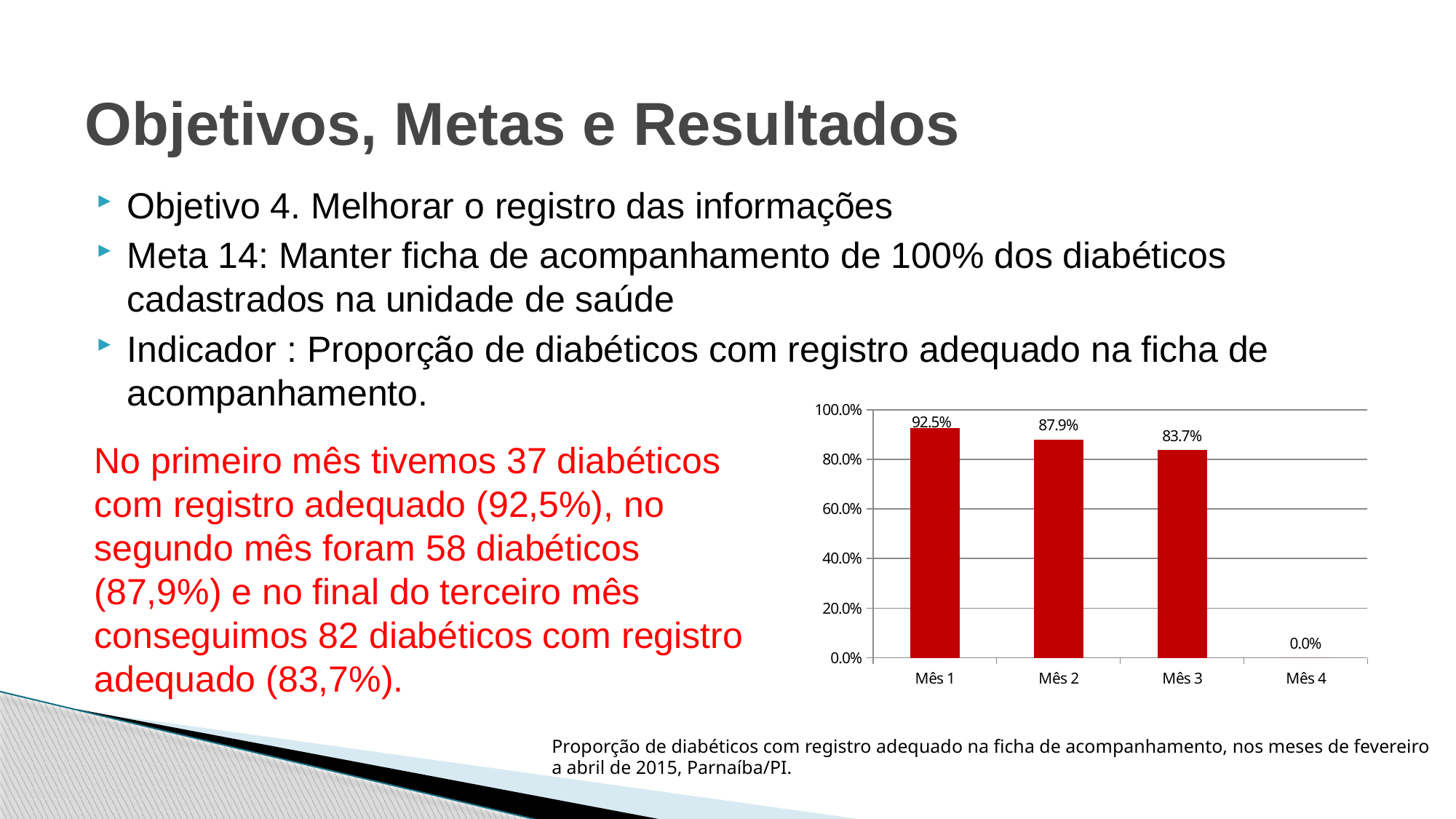
Do the values rise or fall from Mês 1 to Mês 3? fall Which month has the lowest value? Mês 4 What kind of chart is shown? bar chart What is the difference between the values for Mês 1 and Mês 3? 8.8% What is the value for Mês 1? 92.5% How many months are shown on the x axis? 4 Which is larger, the value for Mês 2 or the value for Mês 3? Mês 2 What is the value for Mês 3? 83.7% Which month has the highest value? Mês 1 What is the value for Mês 2? 87.9% What is the value for Mês 4? 0.0% Is the value for Mês 2 greater or less than 80.0%? greater